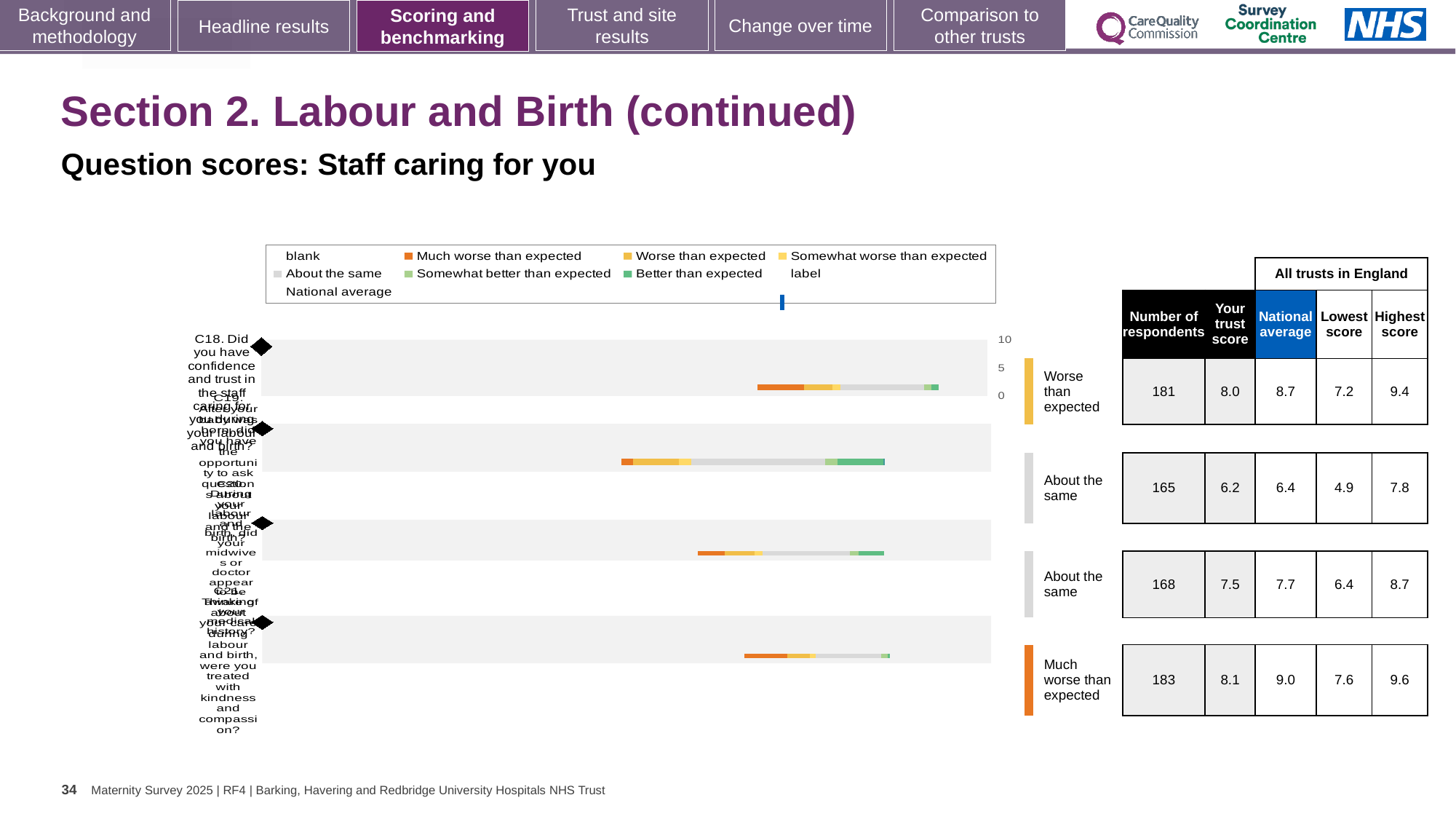
In the table, what is the trust score for the row labelled 'Much worse than expected'? 8.1 What benchmark category label is shown next to the first (top) bar of the chart? Worse than expected What is the difference between the national average and the trust score for the row labelled 'Much worse than expected'? 0.9 Which row of the table has the highest number of respondents? Much worse than expected In the table, what is the number of respondents for the row labelled 'Worse than expected'? 181 How many question bars are plotted in the chart? 4 What is the heading above the 'National average', 'Lowest score' and 'Highest score' columns in the table? All trusts in England What kind of chart is shown on the slide? bar chart In the table, what is the highest score for the row labelled 'Worse than expected'? 9.4 In the table, what is the national average for the row labelled 'Much worse than expected'? 9.0 In the table, what is the lowest score for the second row (labelled 'About the same', 165 respondents)? 4.9 For the row labelled 'Worse than expected', which is larger: the trust score or the national average? National average